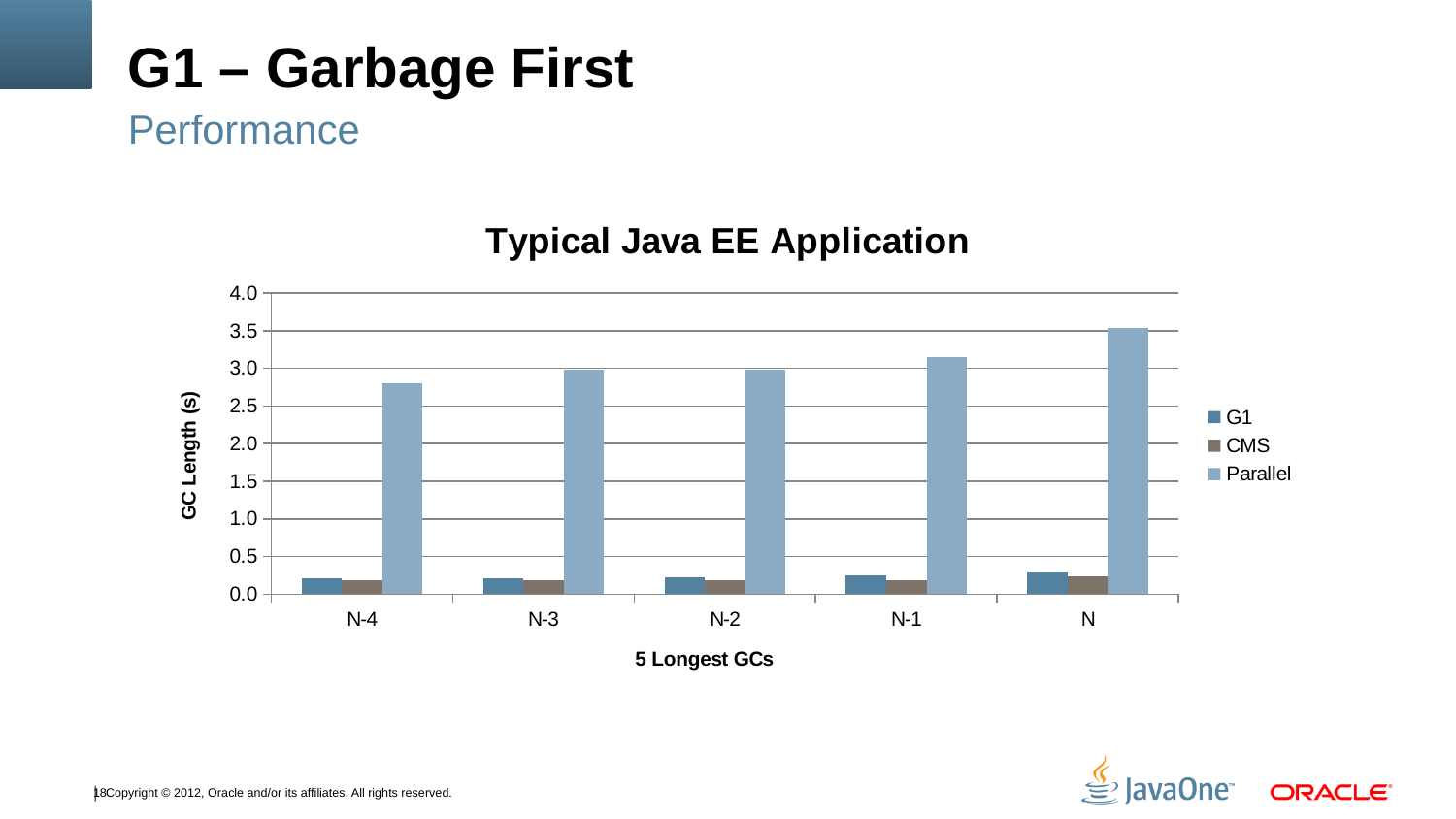
How many categories are shown on the x axis? 5 Which category has the lowest value for the Parallel series? N-4 What is the title of the chart? Typical Java EE Application What is the label of the y axis? GC Length (s) How many series does the legend list? 3 Which is larger at N: the Parallel value or the G1 value? Parallel Is the value for G1 at N greater or less than 0.5? less Is the value for Parallel at N greater or less than 3.0? greater Do the Parallel values generally rise or fall from N-4 to N? rise Which category has the highest value for the Parallel series? N Is the value for Parallel at N-4 greater or less than 3.0? less What kind of chart is shown on the slide? bar chart